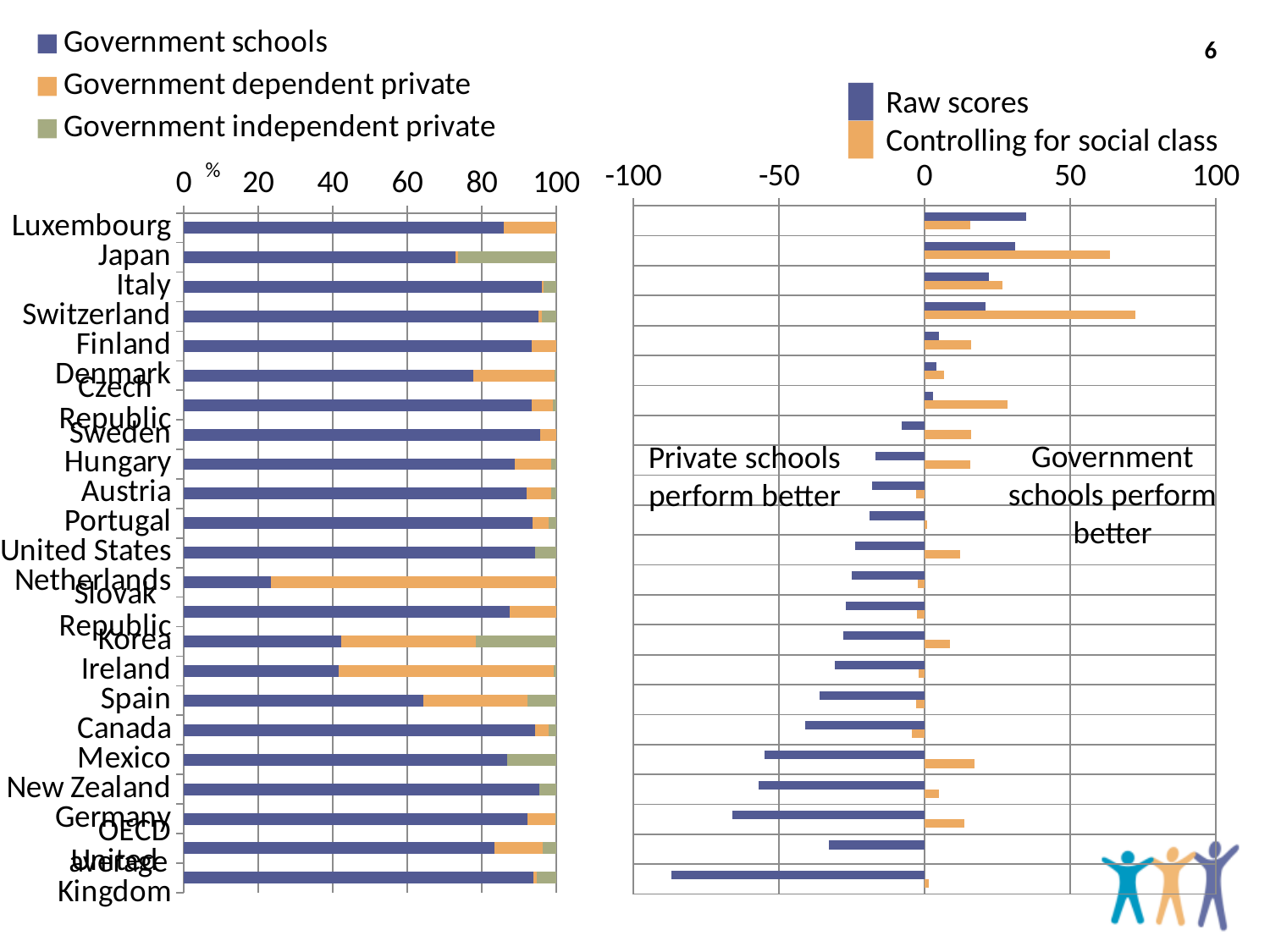
In the left chart, is the government schools share for Luxembourg greater or less than 80%? greater In the left chart, which country has the lowest share of students in government schools? Netherlands In the left chart, is the government schools share for Korea greater or less than 60%? less How many series does the legend of the right chart list? 2 In the right chart, which is larger for Switzerland: the raw score or the value controlling for social class? Controlling for social class In the left chart, which country has the largest share of students in government dependent private schools? Netherlands How many countries (including the OECD average) are plotted in the left chart? 23 In the right chart, which country has the highest value when controlling for social class? Switzerland In the right chart, is the raw score for Germany greater or less than -50? less In the right chart, which country has the lowest raw score? United Kingdom How many series does the legend of the left chart list? 3 What kind of chart is the left chart showing the share of students in government schools, government dependent private and government independent private schools? Stacked bar chart